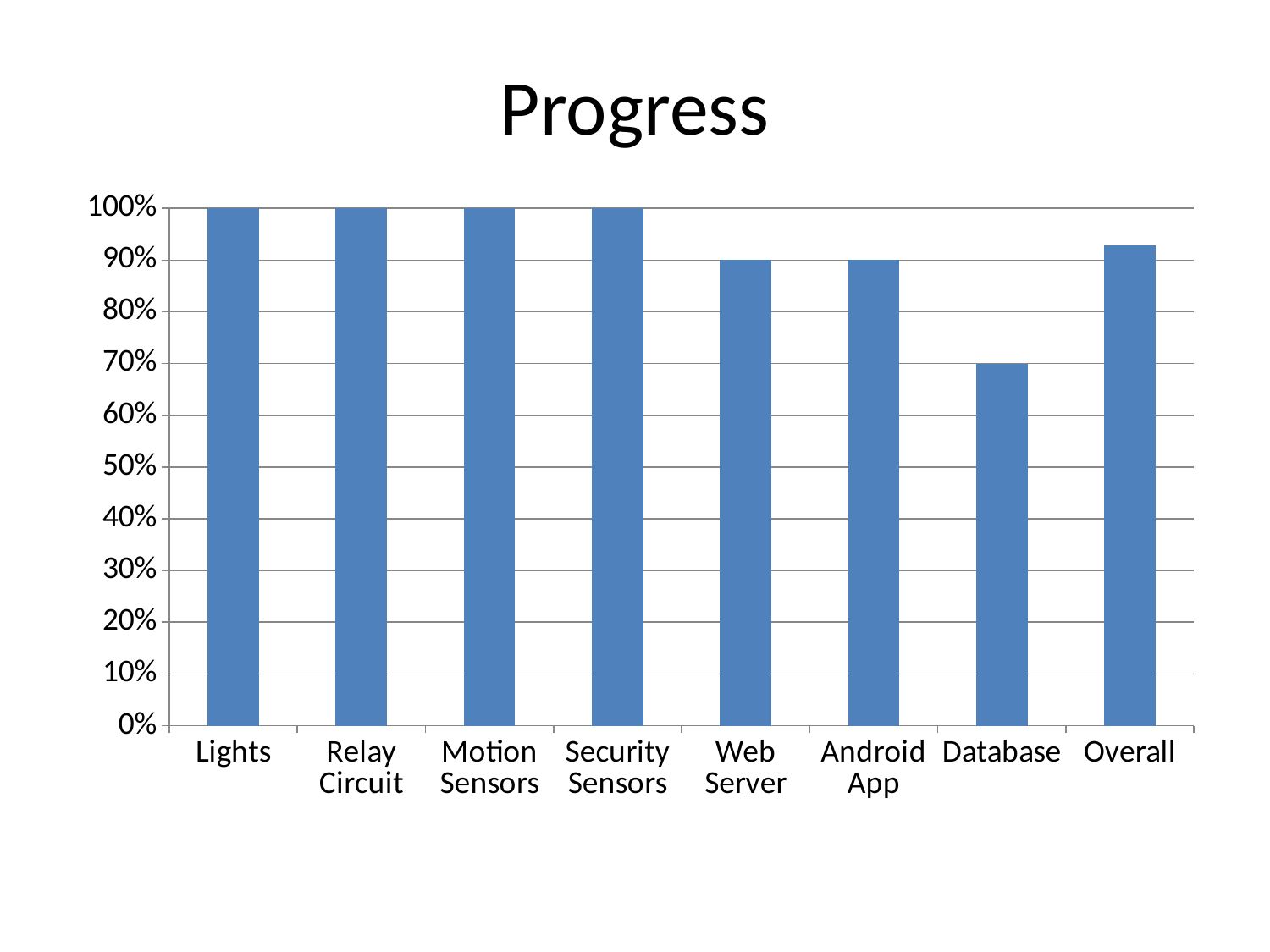
What is the value for Database? 70% What is the difference between the values for Web Server and Database? 20% Is the value for Overall greater or less than 90%? greater What is the value for Lights? 100% Which category has the lowest value? Database What is the title of the slide? Progress What is the value for Web Server? 90% What kind of chart is shown on the slide? bar chart Is the value for Database greater or less than 80%? less Which is larger, the value for Security Sensors or the value for Database? Security Sensors What is the value for Android App? 90% How many categories are shown on the x axis? 8